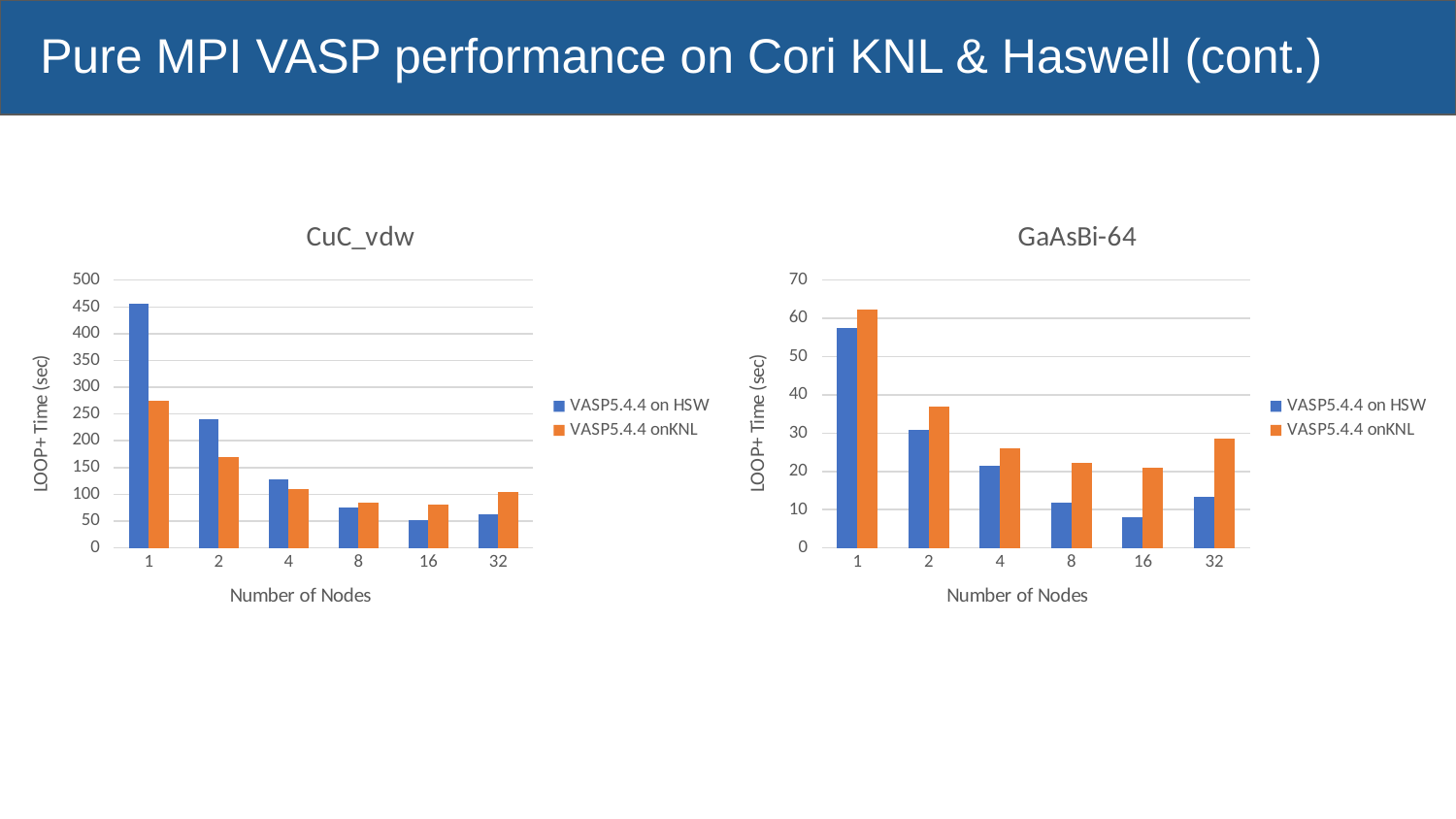
In the CuC_vdw chart, is the value for VASP5.4.4 onKNL at 1 node greater or less than 300? less How many series does the legend of the CuC_vdw chart list? 2 In the GaAsBi-64 chart, is the value for VASP5.4.4 onKNL at 1 node greater or less than 50? greater In the GaAsBi-64 chart, at which number of nodes is the VASP5.4.4 on HSW time lowest? 16 How many node counts are shown on the x axis of the GaAsBi-64 chart? 6 In the CuC_vdw chart, at which number of nodes is the VASP5.4.4 on HSW time lowest? 16 In the CuC_vdw chart, at 2 nodes, which series has the larger LOOP+ time? VASP5.4.4 on HSW In the CuC_vdw chart, is the value for VASP5.4.4 on HSW at 1 node greater or less than 400? greater In the GaAsBi-64 chart, at 32 nodes, which series has the larger LOOP+ time? VASP5.4.4 onKNL In the CuC_vdw chart, at which number of nodes is the VASP5.4.4 on HSW time highest? 1 What kind of chart is the CuC_vdw chart? bar chart